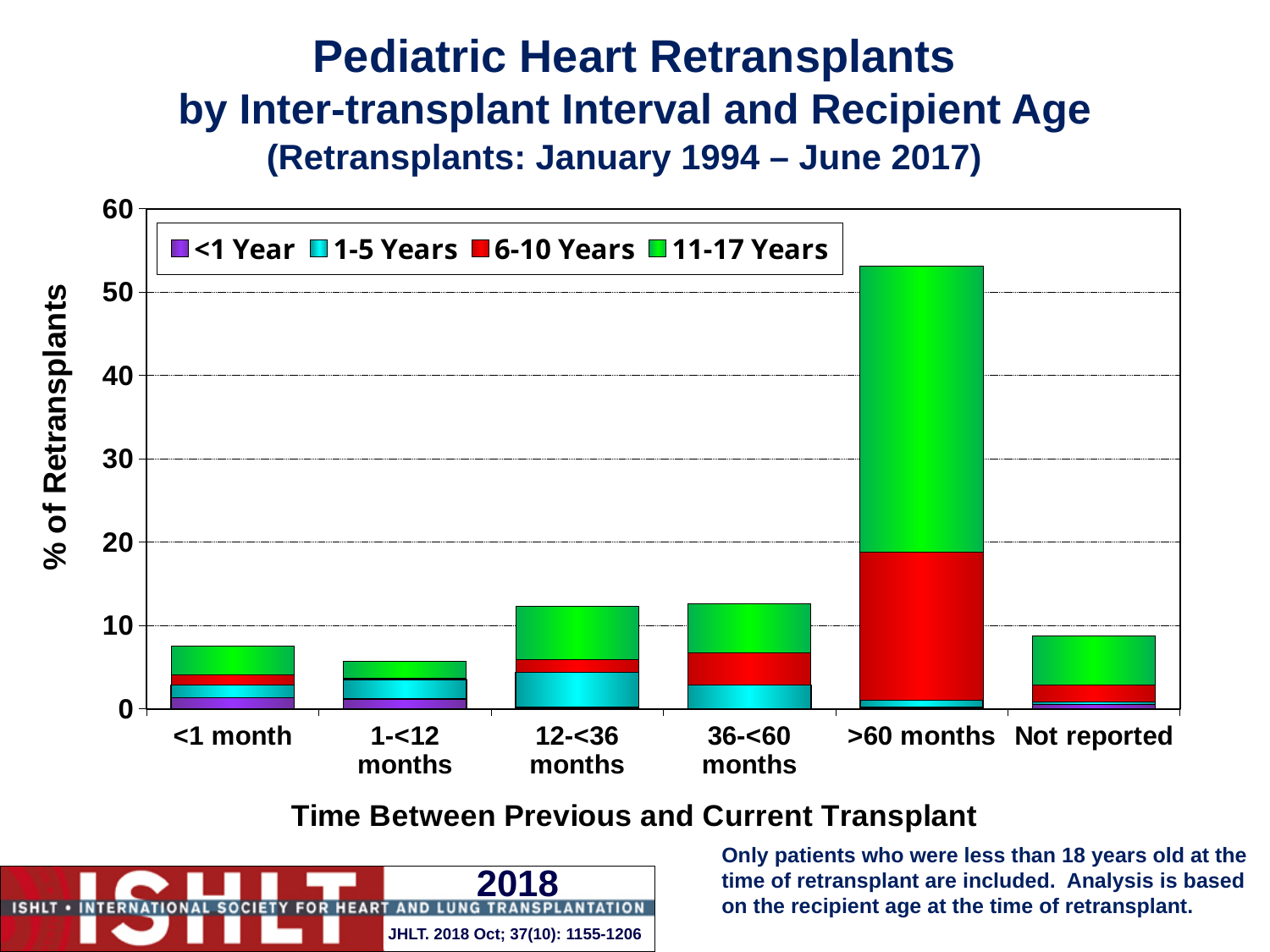
Is the total value for 12-<36 months greater or less than 10? greater Is the total value for <1 month greater or less than 10? less Is the total value for >60 months greater or less than 50? greater Which has a larger total percentage of retransplants, >60 months or Not reported? >60 months Which recipient age group is shown in green in the legend? 11-17 Years Which inter-transplant interval has the highest total percentage of retransplants? >60 months What kind of chart is shown on the slide? Stacked bar chart What is the label of the y axis? % of Retransplants How many inter-transplant interval categories are shown on the x axis? 6 Which inter-transplant interval has the lowest total percentage of retransplants? 1-<12 months How many recipient age groups does the legend list? 4